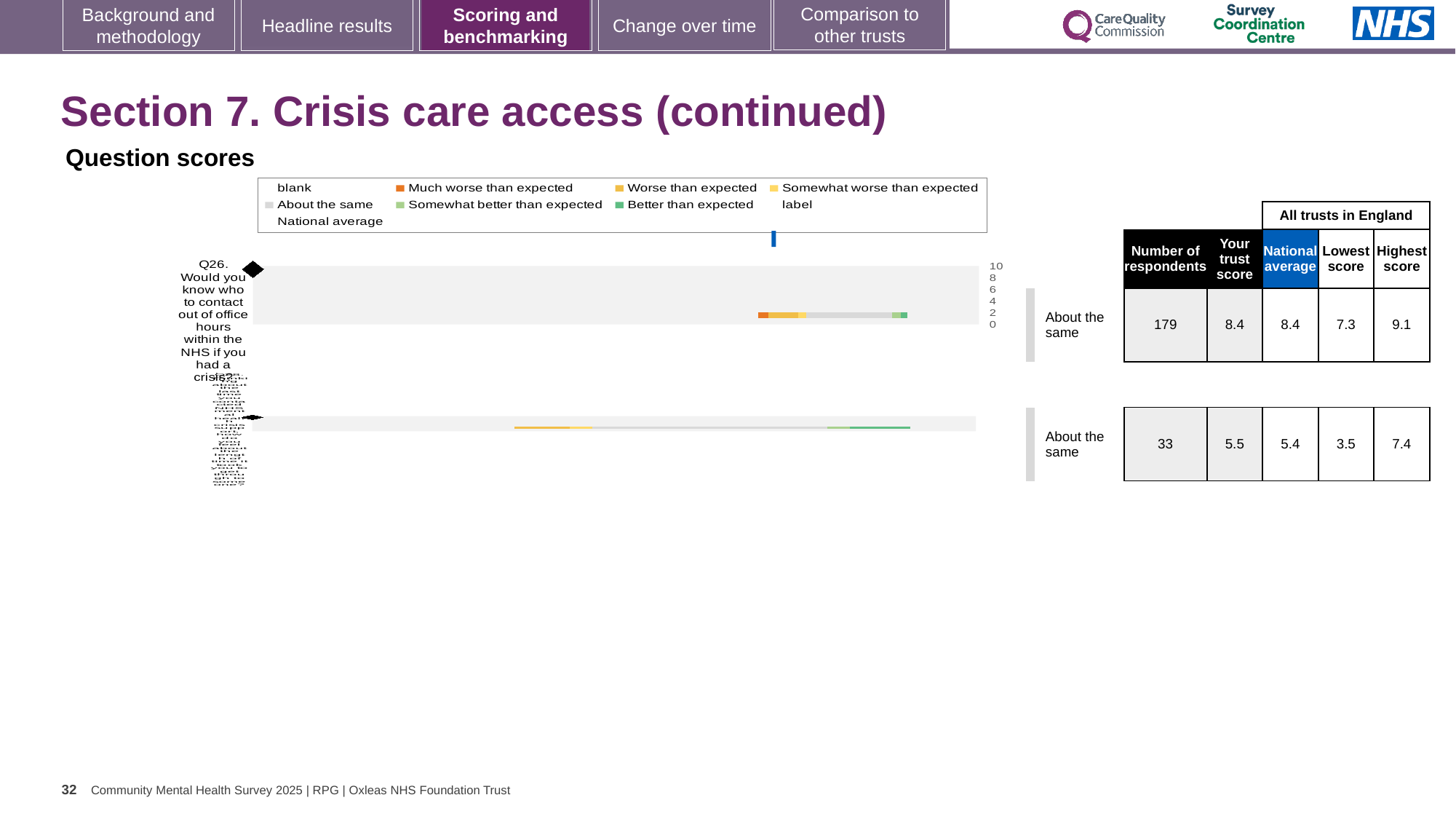
Is the trust's score for Q26 higher than, lower than, or equal to the national average? equal Which colour in the legend represents 'Better than expected'? green Which colour in the legend represents 'Much worse than expected'? orange What is the trust's score for Q26? 8.4 What is the highest score among all trusts in England for Q26? 9.1 How is the trust's result for Q26 categorised relative to expectations? About the same What kind of chart is used to show the question scores on this slide? bar chart How many question rows are plotted in the chart? 2 What is the difference between the highest and lowest trust scores in England for Q26? 1.8 How many respondents answered Q26 (Would you know who to contact out of office hours within the NHS if you had a crisis?)? 179 What is the national average score for Q26? 8.4 What is the lowest score among all trusts in England for Q26? 7.3